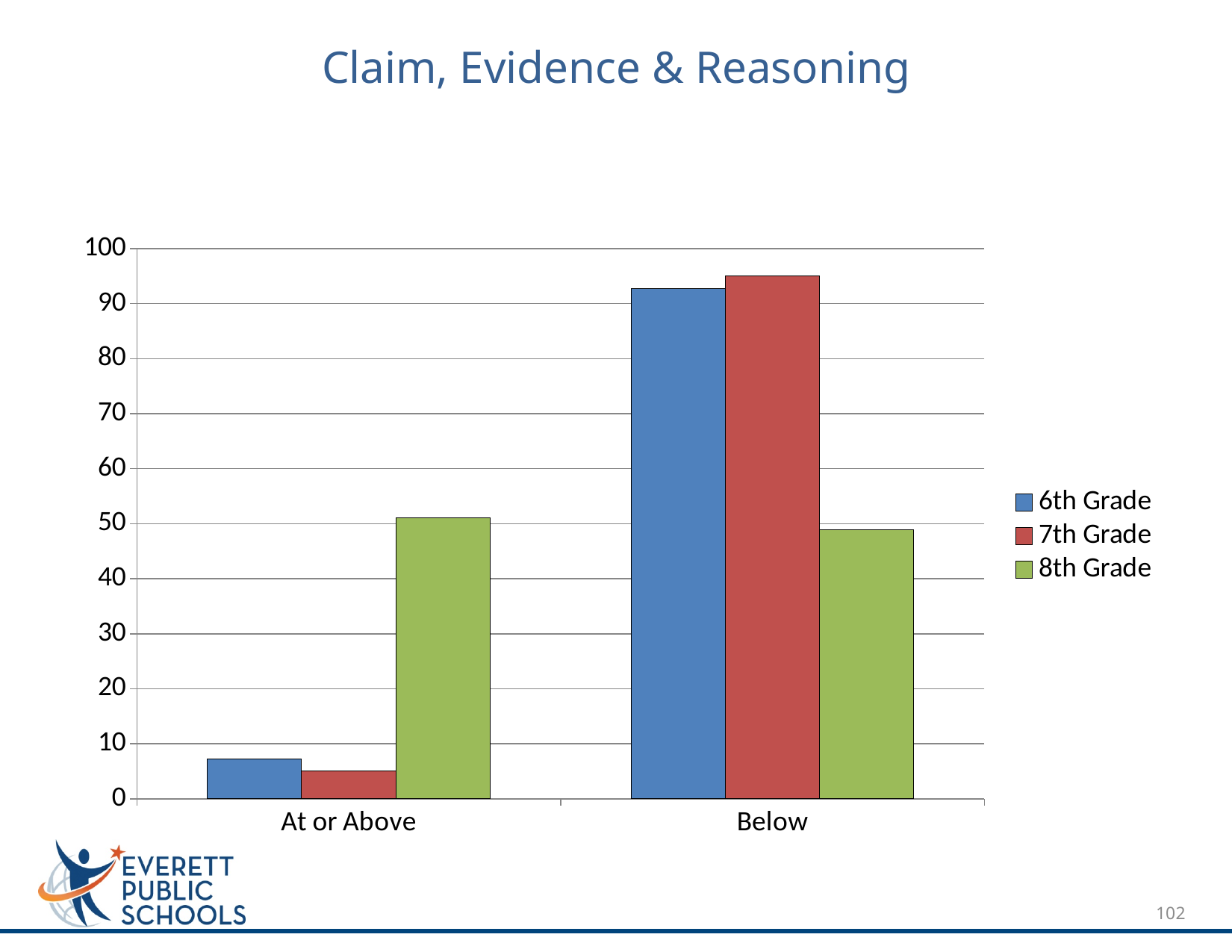
How many categories are shown on the x axis? 2 What kind of chart is shown on the slide? bar chart Which series does the green bar represent? 8th Grade Which grade has the highest value in the At or Above category? 8th Grade Is the value for 8th Grade in the At or Above category greater or less than 40? greater How many series does the legend list? 3 In the Below category, which is larger: the value for 7th Grade or the value for 8th Grade? 7th Grade Is the value for 7th Grade in the At or Above category greater or less than 10? less What is the title of the chart? Claim, Evidence & Reasoning Is the value for 8th Grade in the Below category greater or less than 60? less Which grade has the lowest value in the Below category? 8th Grade